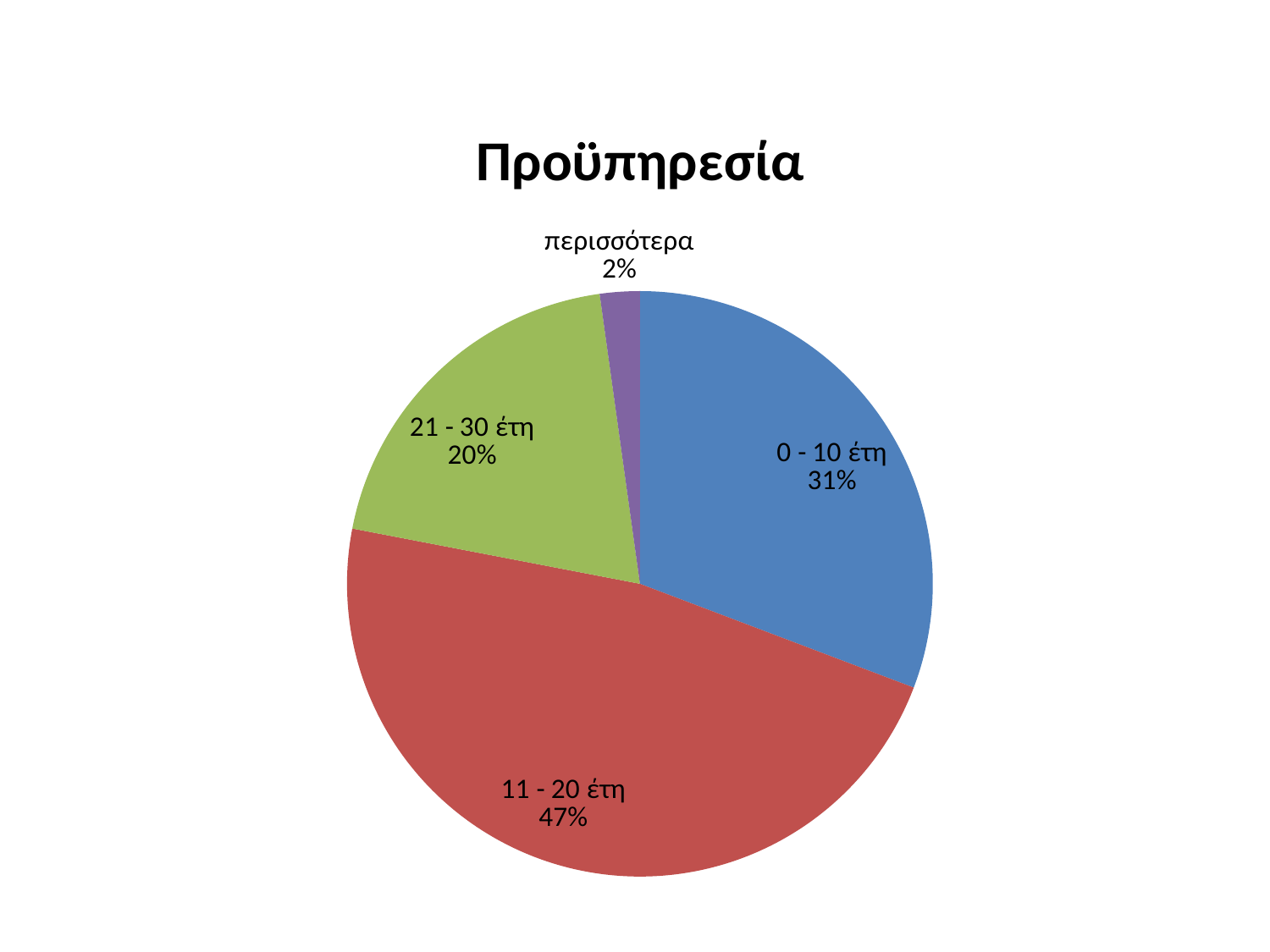
Which category has the smallest slice of the pie? περισσότερα What share of the pie does the '21 - 30 έτη' slice represent? 20% What share of the pie does the 'περισσότερα' slice represent? 2% What is the difference in percentage points between the '11 - 20 έτη' slice and the '0 - 10 έτη' slice? 16 Which category has the largest slice of the pie? 11 - 20 έτη What share of the pie does the '0 - 10 έτη' slice represent? 31% What is the title of the chart? Προϋπηρεσία What kind of chart is shown on the slide? Pie chart What is the difference in percentage points between the '21 - 30 έτη' slice and the 'περισσότερα' slice? 18 Which is larger, the '0 - 10 έτη' slice or the '21 - 30 έτη' slice? 0 - 10 έτη How many slices does the pie chart have? 4